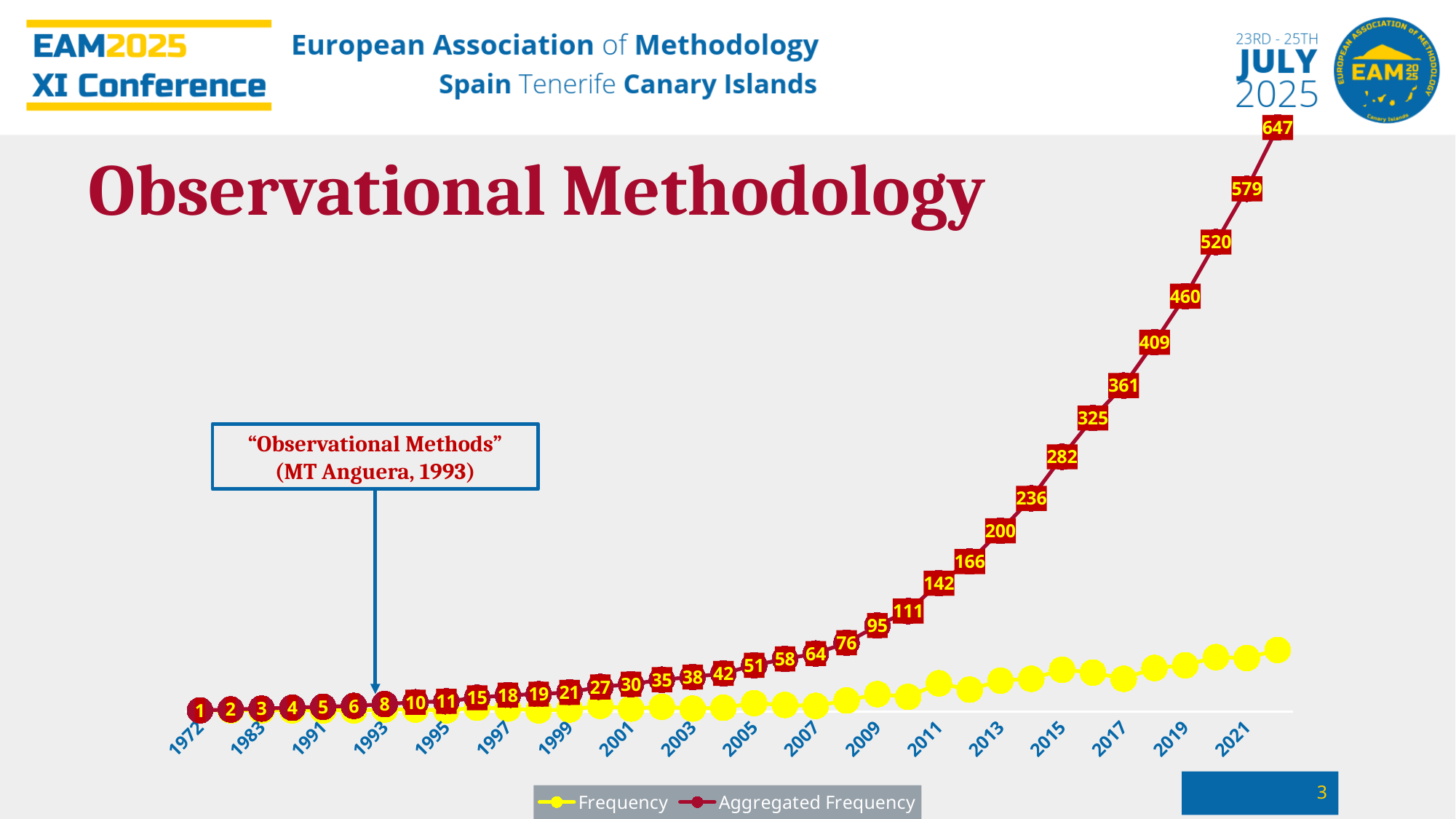
What is the difference between the last two Aggregated Frequency values, 647 and 579? 68 What is the Aggregated Frequency value at 2021? 579 How many year labels are shown on the x axis? 18 How many series does the chart legend list? 2 What is the highest value shown for the Aggregated Frequency series? 647 What kind of chart is shown on the slide? line chart What is the lowest value shown for the Aggregated Frequency series? 1 At 2021, which series has the larger value, Frequency or Aggregated Frequency? Aggregated Frequency What are the two series names listed in the legend? Frequency and Aggregated Frequency What is the Aggregated Frequency value at 2011? 142 What is the Aggregated Frequency value at 1993? 8 Does the Aggregated Frequency series rise or fall along the x axis? rises